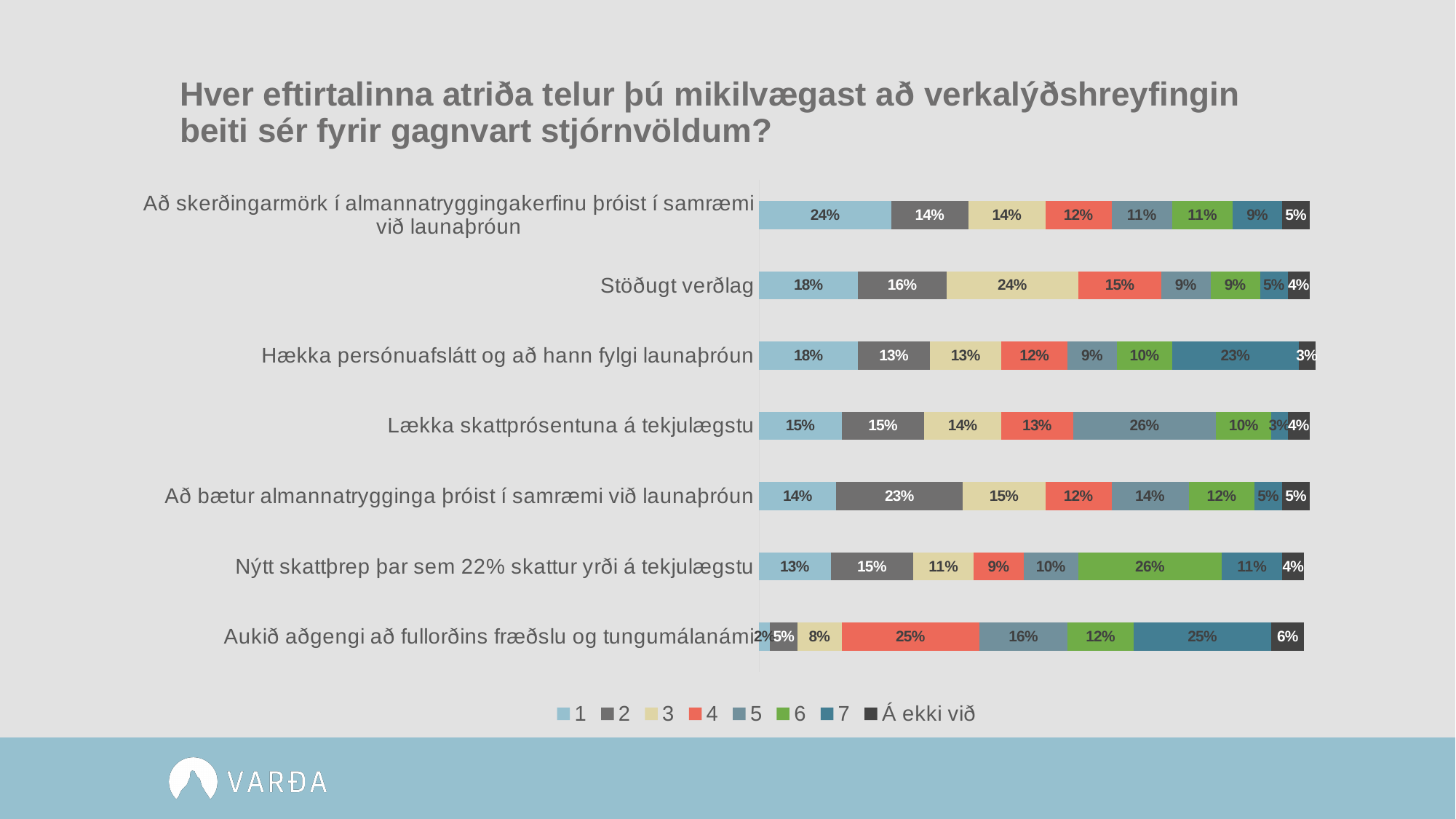
What is the value of series 1 for "Stöðugt verðlag"? 18% What kind of chart is shown on the slide? Stacked bar chart What is the value of series 5 for "Lækka skattprósentuna á tekjulægstu"? 26% What is the difference between the series 2 value for "Að bætur almannatrygginga þróist í samræmi við launaþróun" and the series 2 value for "Stöðugt verðlag"? 7% What is the value of series 4 for "Aukið aðgengi að fullorðins fræðslu og tungumálanámi"? 25% Which is larger: the series 6 value for "Nýtt skattþrep þar sem 22% skattur yrði á tekjulægstu" or the series 6 value for "Stöðugt verðlag"? Nýtt skattþrep þar sem 22% skattur yrði á tekjulægstu How many series does the legend list? 8 What is the value of series 7 for "Hækka persónuafslátt og að hann fylgi launaþróun"? 23% Which category has the highest value for series 1? Að skerðingarmörk í almannatryggingakerfinu þróist í samræmi við launaþróun Which category has the lowest value for series 1? Aukið aðgengi að fullorðins fræðslu og tungumálanámi What is the label of the last entry in the legend? Á ekki við How many categories (rows) does the chart show? 7